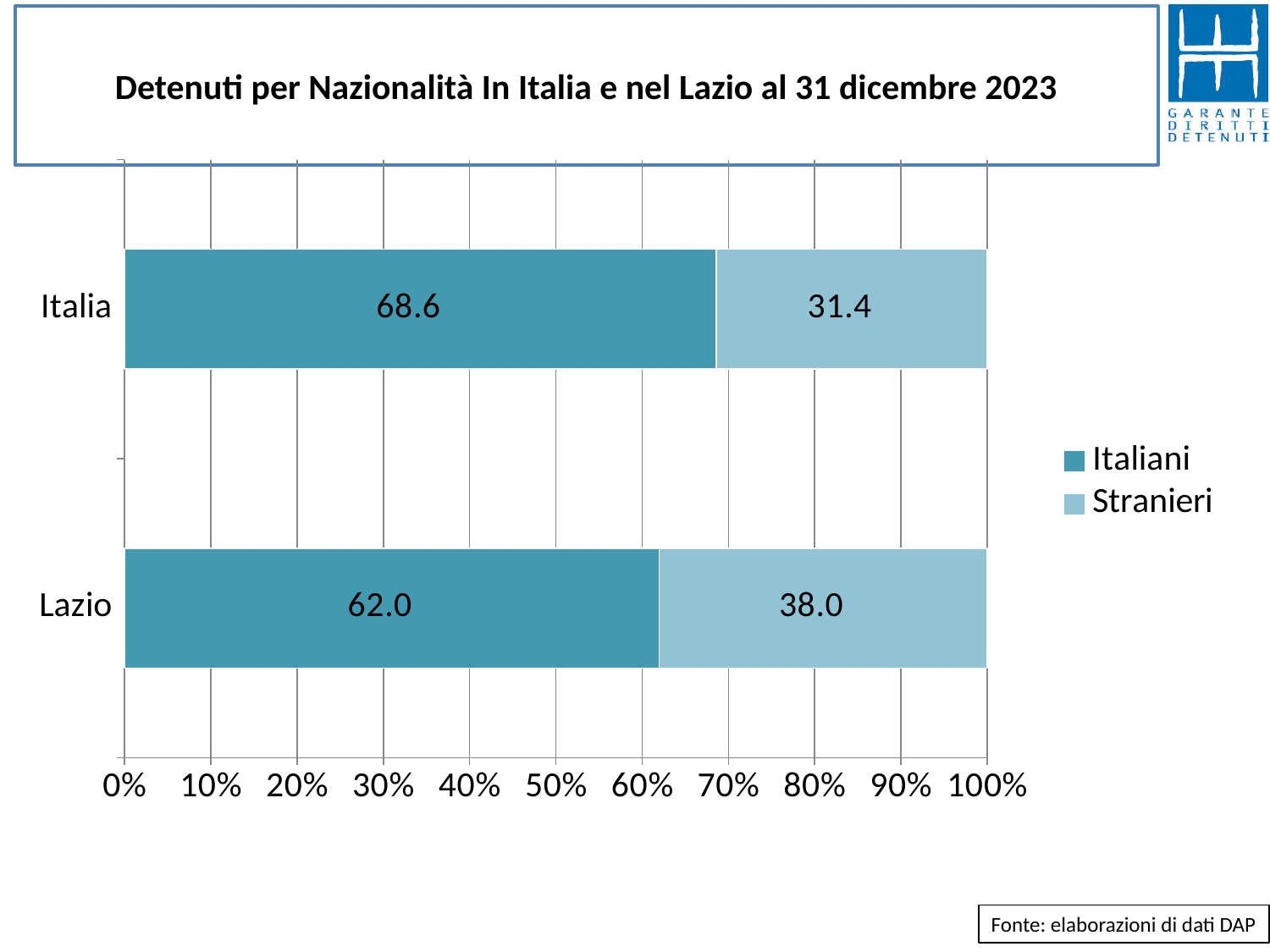
What is the difference between the Italiani values for Italia and Lazio? 6.6 What is the value for Italiani in Lazio? 62.0 Which category has the higher Italiani value, Italia or Lazio? Italia How many categories are shown on the chart? 2 What is the title of the chart? Detenuti per Nazionalità In Italia e nel Lazio al 31 dicembre 2023 What kind of chart is shown on the slide? Stacked bar chart What is the value for Stranieri in Lazio? 38.0 What is the difference between the Italiani and Stranieri values for Lazio? 24.0 How many series does the legend list? 2 What is the value for Italiani in Italia? 68.6 Which category has the lower Stranieri value? Italia What is the value for Stranieri in Italia? 31.4